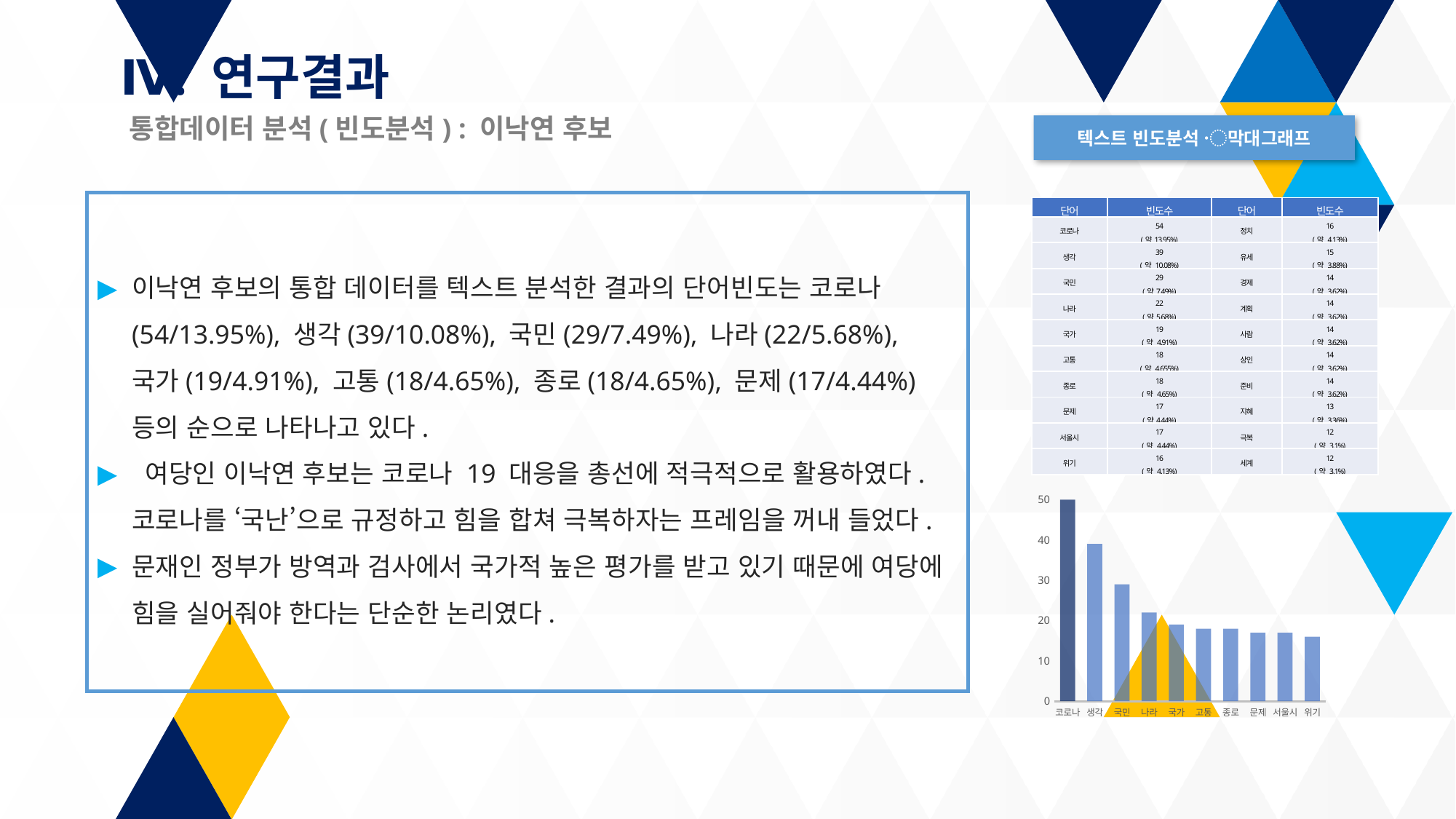
In the bar chart, is the value for 위기 greater or less than 20? less According to the frequency table on the slide, what is the frequency (빈도수) of 생각? 39 In the bar chart, which bar is taller, 생각 or 국민? 생각 What kind of chart is shown at the bottom right of the slide? bar chart What is the highest tick value shown on the y axis of the bar chart? 50 In the bar chart, is the value for 국민 greater or less than 20? greater Do the bar values rise or fall from left to right along the x axis of the bar chart? fall How many categories (words) are plotted on the x axis of the bar chart? 10 Which word has the highest bar in the bar chart? 코로나 In the bar chart, is the value for 생각 greater or less than 30? greater Which word has the lowest bar in the bar chart? 위기 According to the frequency table on the slide, what is the frequency (빈도수) of 코로나? 54